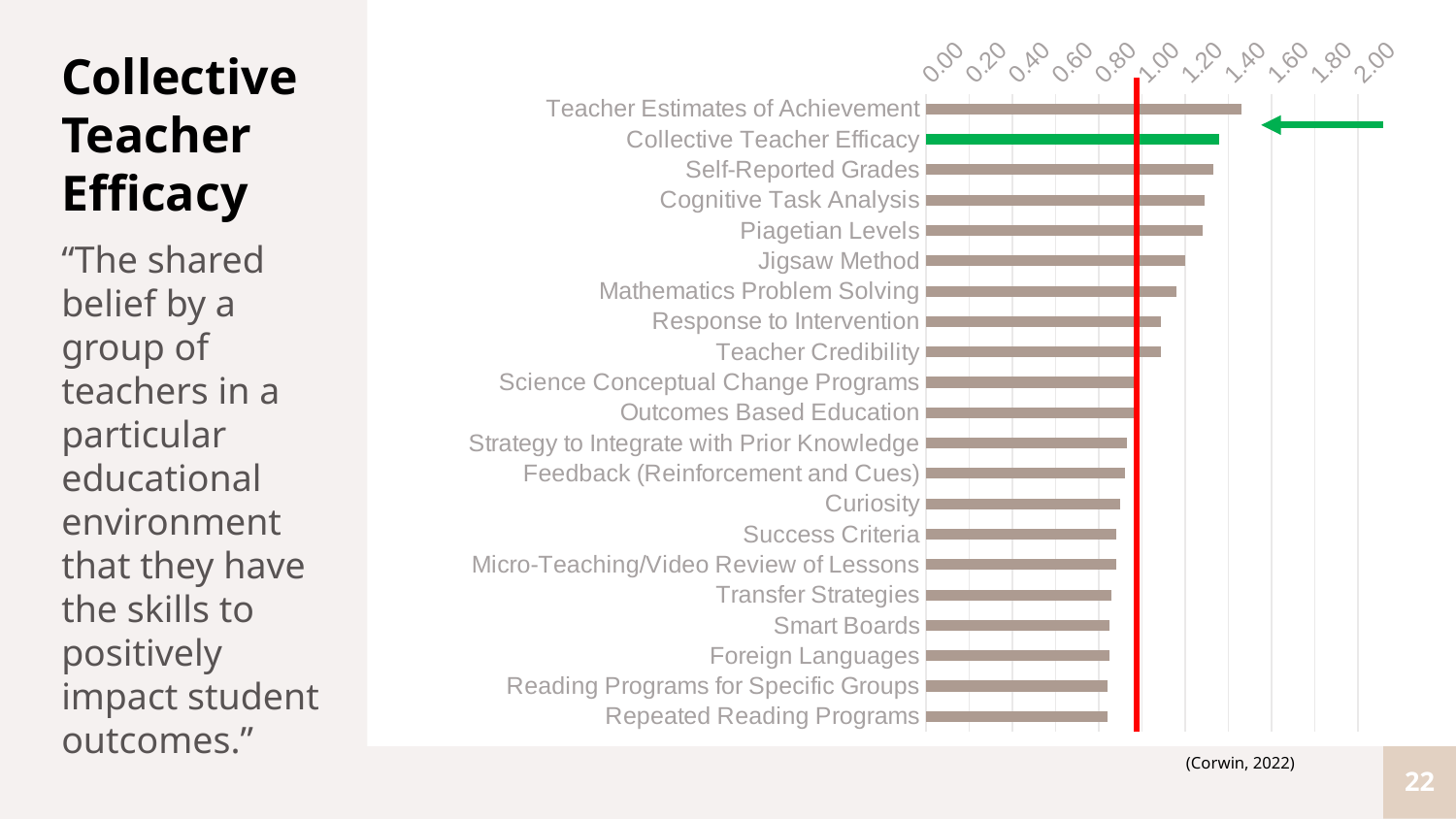
Is the value for Curiosity greater or less than 1.00? less Which category has the longest bar in the chart? Teacher Estimates of Achievement How many categories (bars) are plotted in the chart? 21 Do the bar values increase or decrease going from the top of the chart to the bottom? decrease Is the value for Smart Boards greater or less than 1.00? less Is the value for Jigsaw Method greater or less than 1.00? greater What kind of chart is shown on the slide? bar chart Which is larger, the value for Collective Teacher Efficacy or the value for Success Criteria? Collective Teacher Efficacy Which is larger, the value for Teacher Estimates of Achievement or the value for Jigsaw Method? Teacher Estimates of Achievement Which bar is highlighted in green? Collective Teacher Efficacy